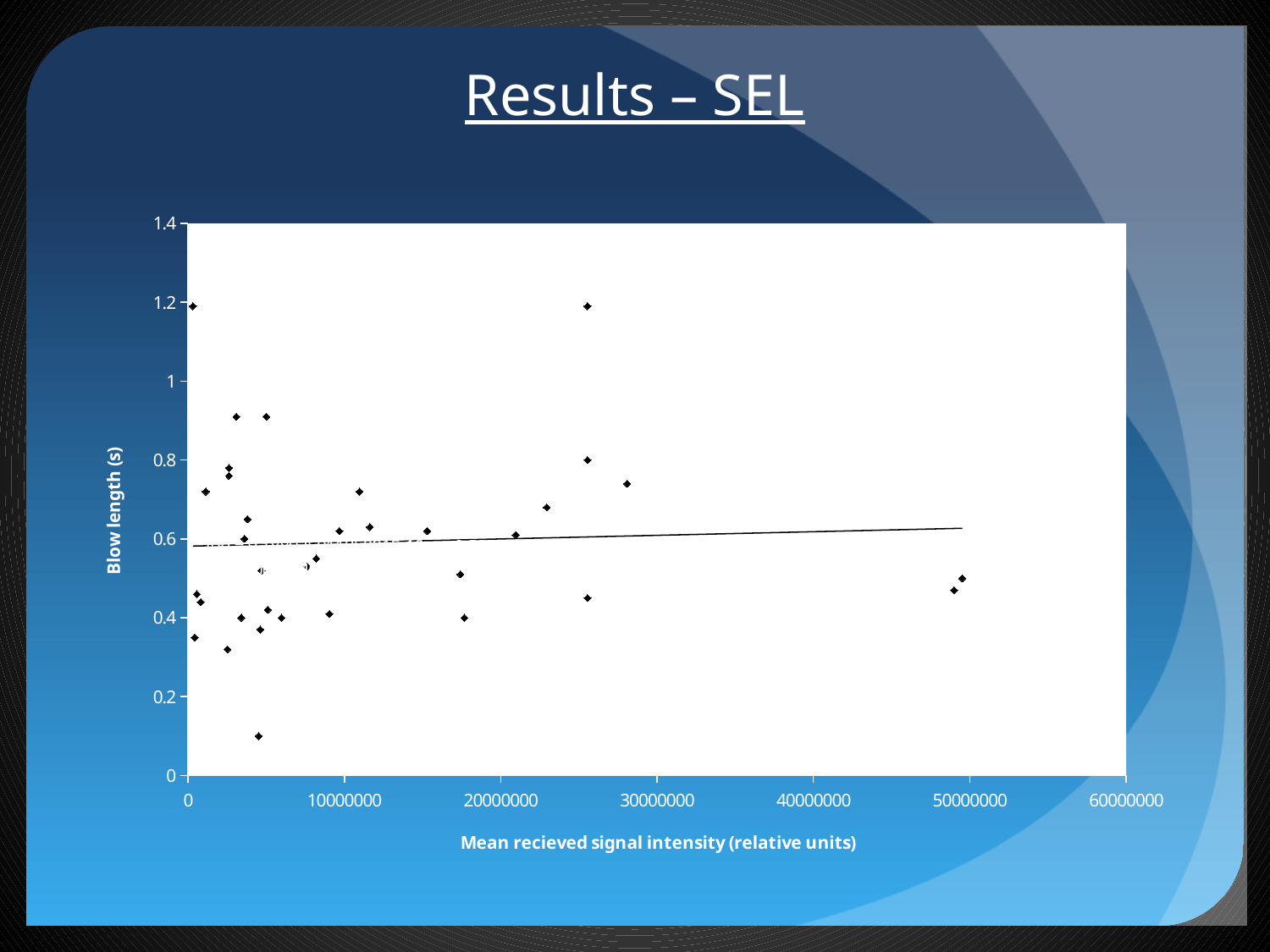
Are there any points plotted beyond 50000000 on the x axis? No Is the blow length of the highest point plotted near 25000000 on the x axis greater or less than 1.0? greater What is the label of the x axis? Mean recieved signal intensity (relative units) What is the highest value shown on the y axis? 1.4 What is the label of the y axis? Blow length (s) What kind of chart is shown on the slide? Scatter plot Are the blow lengths of the points plotted near 50000000 on the x axis greater or less than 0.6? less